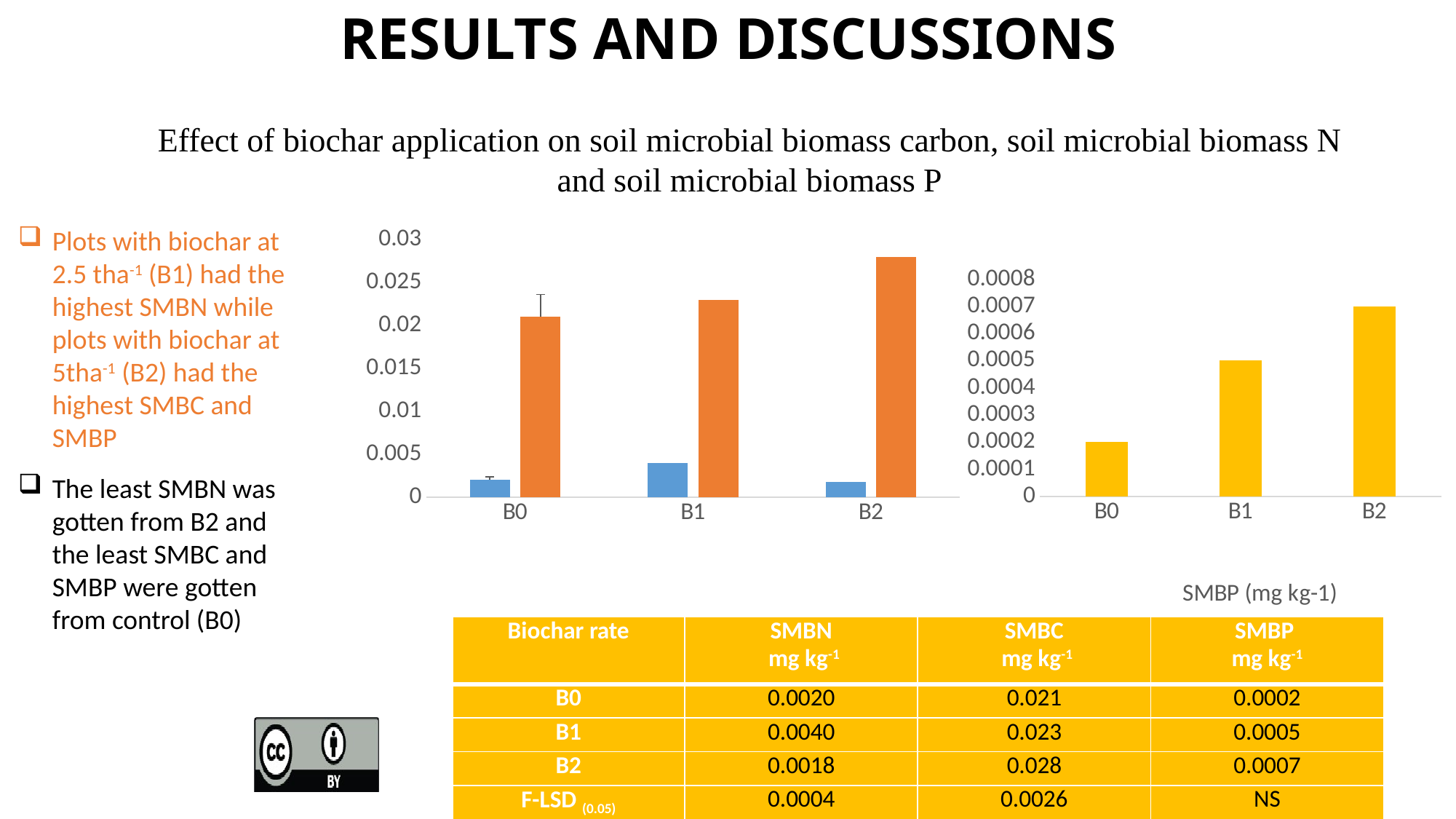
In the right chart (SMBP), what is the value for B1? 0.0005 How many categories are shown on the x axis of the left chart? 3 In the left chart, is the blue bar for B1 greater or less than 0.005? less In the left chart, is the orange bar for B2 greater or less than 0.025? greater In the right chart (SMBP), do the values rise or fall from B0 to B2? rise In the right chart (SMBP), which category has the lowest value? B0 In the right chart (SMBP), what is the value for B2? 0.0007 In the left chart, which category has the tallest orange bar? B2 In the right chart (SMBP), which category has the highest value? B2 In the right chart (SMBP), what is the difference between the values for B2 and B0? 0.0005 In the right chart (SMBP), what is the value for B0? 0.0002 What kind of chart is the chart on the right (SMBP)? bar chart